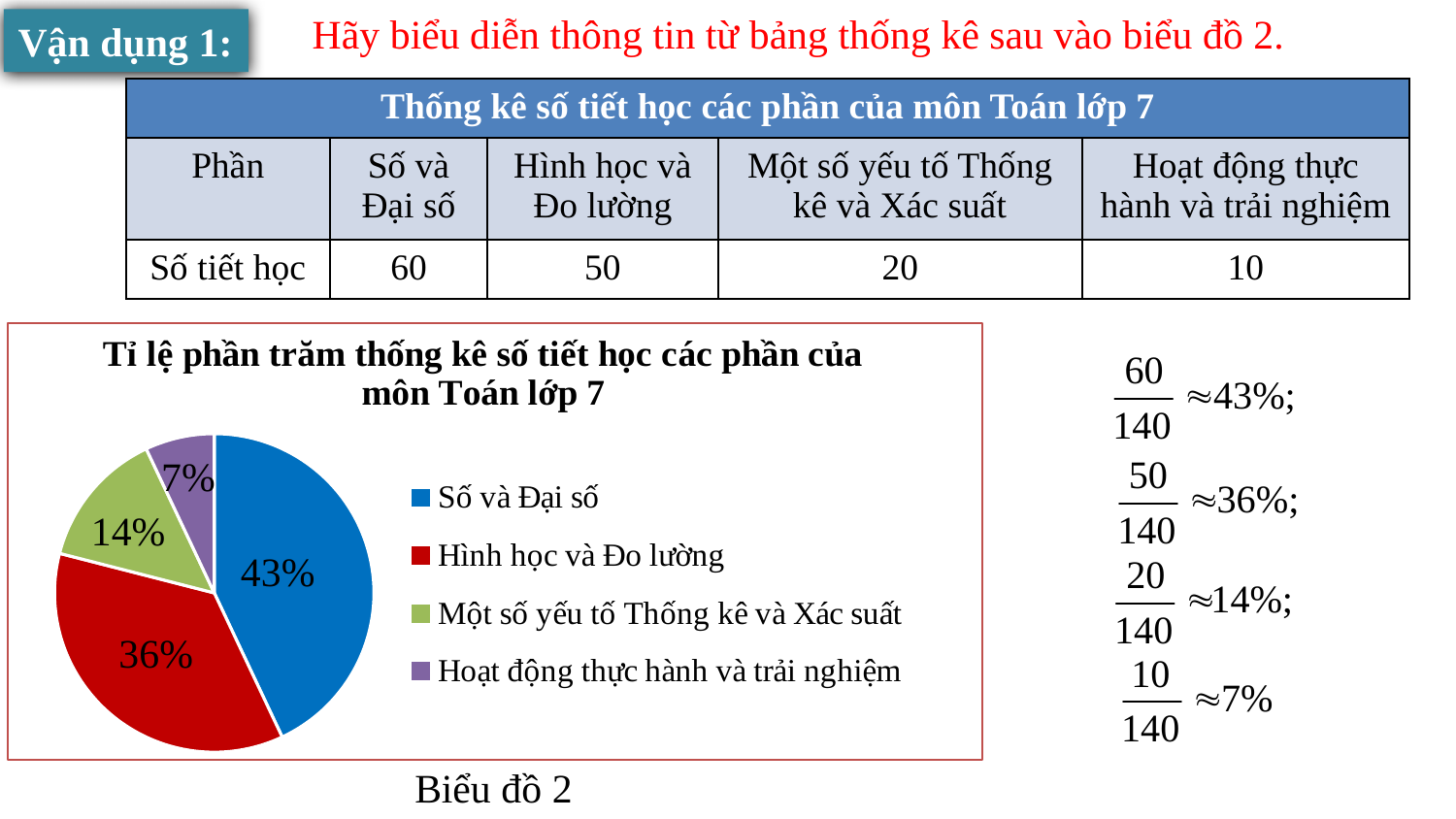
What is the title of the pie chart? Tỉ lệ phần trăm thống kê số tiết học các phần của môn Toán lớp 7 Which category has the largest slice in the pie chart? Số và Đại số What is the difference in percentage points between Số và Đại số and Hình học và Đo lường in the pie chart? 7 Which category has the smallest slice in the pie chart? Hoạt động thực hành và trải nghiệm What percentage does the pie chart show for Hình học và Đo lường? 36% What colour is the slice for Hình học và Đo lường in the pie chart? red How many slices does the pie chart have? 4 What percentage does the pie chart show for Hoạt động thực hành và trải nghiệm? 7% What percentage does the pie chart show for Một số yếu tố Thống kê và Xác suất? 14% What percentage does the pie chart show for Số và Đại số? 43% Which is larger in the pie chart: Một số yếu tố Thống kê và Xác suất or Hoạt động thực hành và trải nghiệm? Một số yếu tố Thống kê và Xác suất What kind of chart is shown on the slide? pie chart